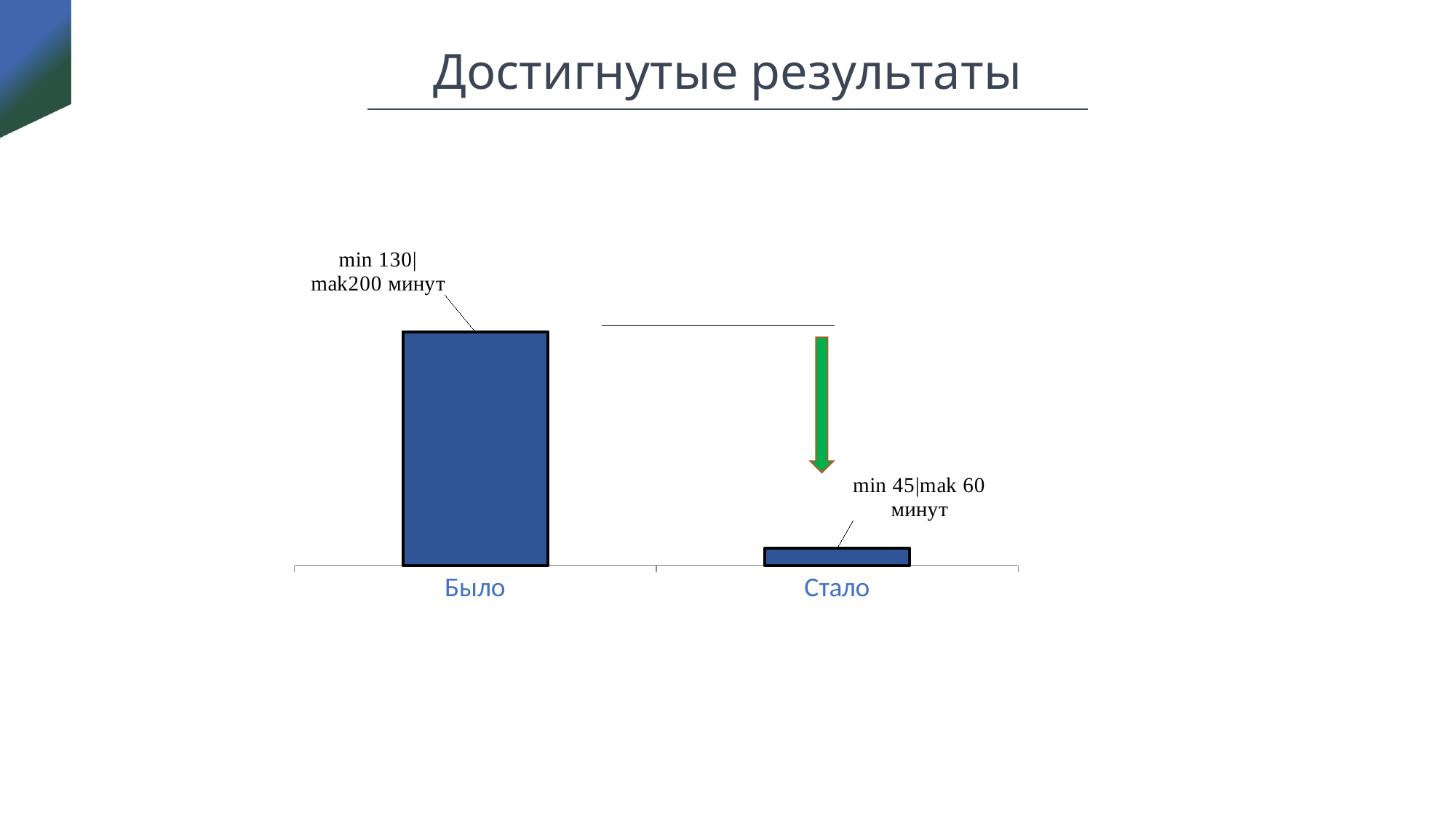
What kind of chart is shown on the slide? bar chart Which category has the taller bar, Было or Стало? Было What is the difference between the minimum minutes for Было (130) and for Стало (45)? 85 What is the title of the slide containing the chart? Достигнутые результаты What is the data label printed above the bar for Было? min 130| mak200 минут Which category has the highest bar in the chart? Было Which category has the lowest bar in the chart? Стало What is the maximum number of minutes given for Было? 200 What is the data label printed above the bar for Стало? min 45|mak 60 минут What is the minimum number of minutes given for Стало? 45 How many categories are shown on the x axis of the chart? 2 Do the bar values rise or fall from Было to Стало? fall